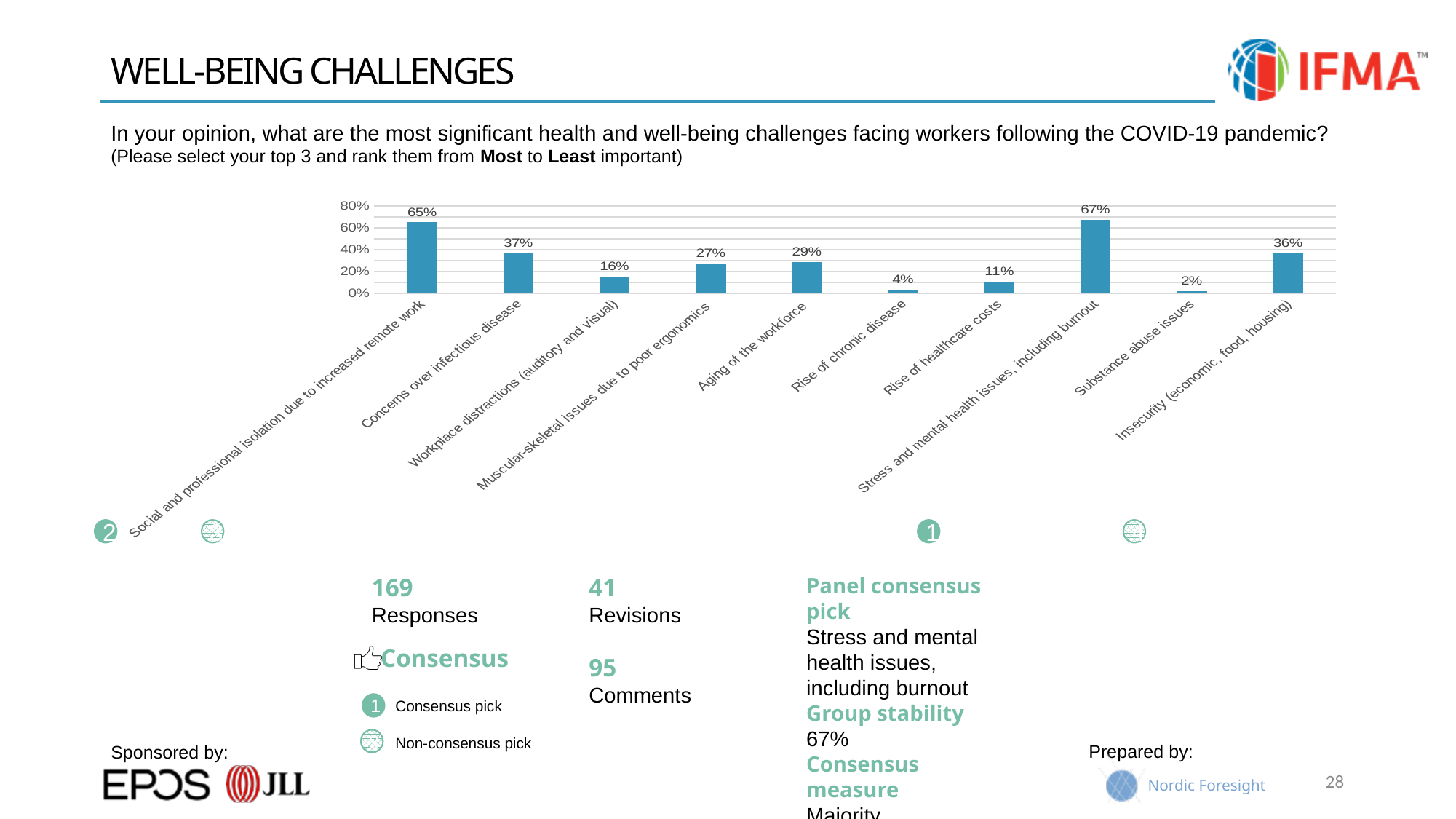
What percentage is shown for "Stress and mental health issues, including burnout"? 67% Which category has the highest value in the chart? Stress and mental health issues, including burnout How many categories are shown in the chart? 10 What type of chart is shown on the slide? Bar chart What percentage is shown for "Social and professional isolation due to increased remote work"? 65% Which is larger: the value for "Muscular-skeletal issues due to poor ergonomics" or the value for "Workplace distractions (auditory and visual)"? Muscular-skeletal issues due to poor ergonomics What is the value for "Rise of healthcare costs"? 11% What is the difference between the values for "Concerns over infectious disease" and "Insecurity (economic, food, housing)"? 1% What is the difference between the values for "Stress and mental health issues, including burnout" and "Social and professional isolation due to increased remote work"? 2% What is the value for "Aging of the workforce"? 29% What is the highest value shown on the chart's vertical axis? 80% Which category has the lowest value in the chart? Substance abuse issues